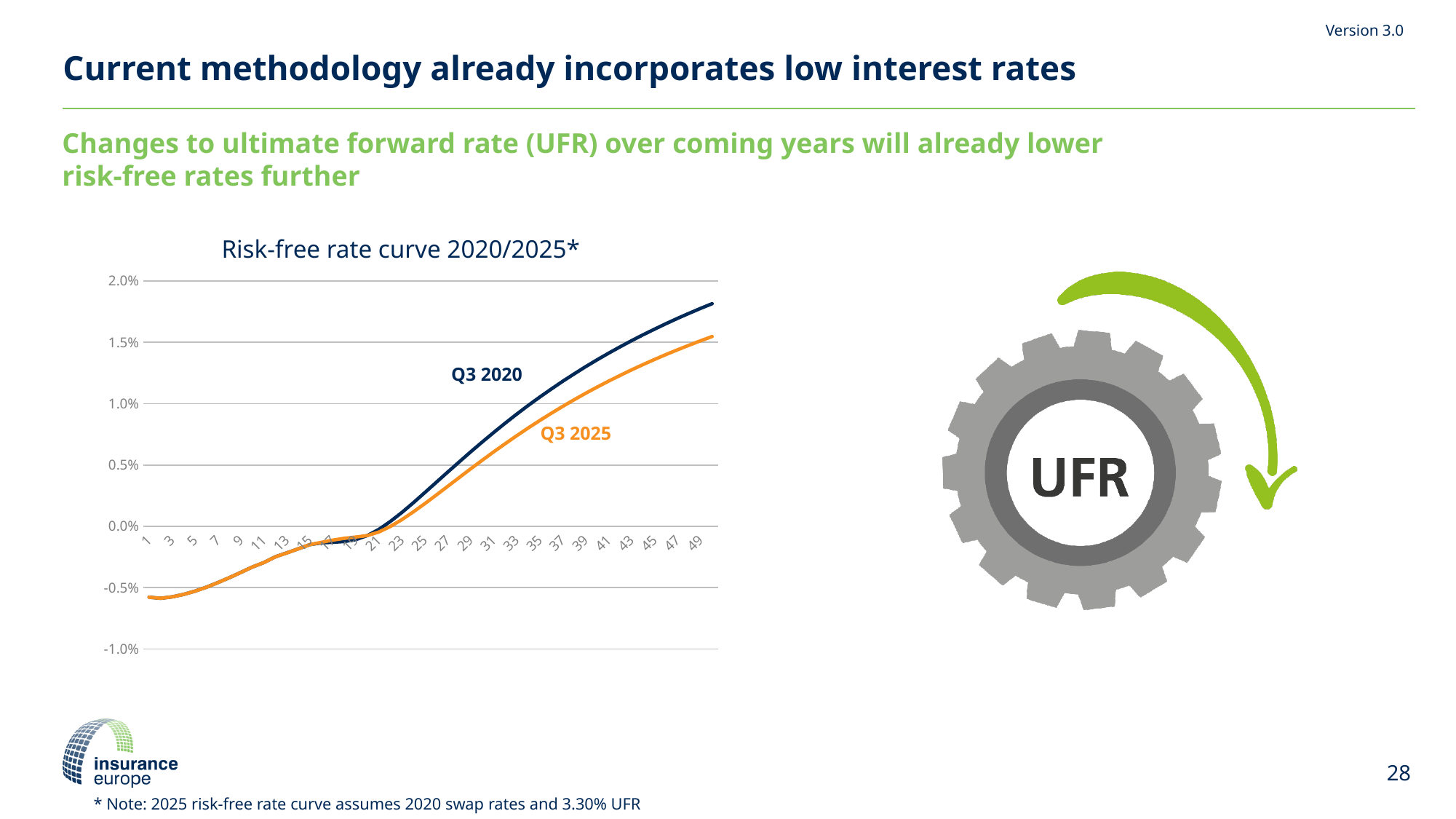
Does the Q3 2020 curve rise or fall overall from year 1 to year 49? rise Is the value of the Q3 2020 curve at year 1 greater or less than -0.5%? less At year 49, which series has the higher value, Q3 2020 or Q3 2025? Q3 2020 Is the value of the Q3 2025 curve at year 49 greater or less than 1.0%? greater Is the value of the Q3 2020 curve at year 29 greater or less than 0.5%? greater Which series is drawn in orange? Q3 2025 What is the highest value labelled on the y axis? 2.0% What kind of chart is shown on the slide? line chart How many series are plotted in the Risk-free rate curve chart? 2 What is the title of the chart? Risk-free rate curve 2020/2025*